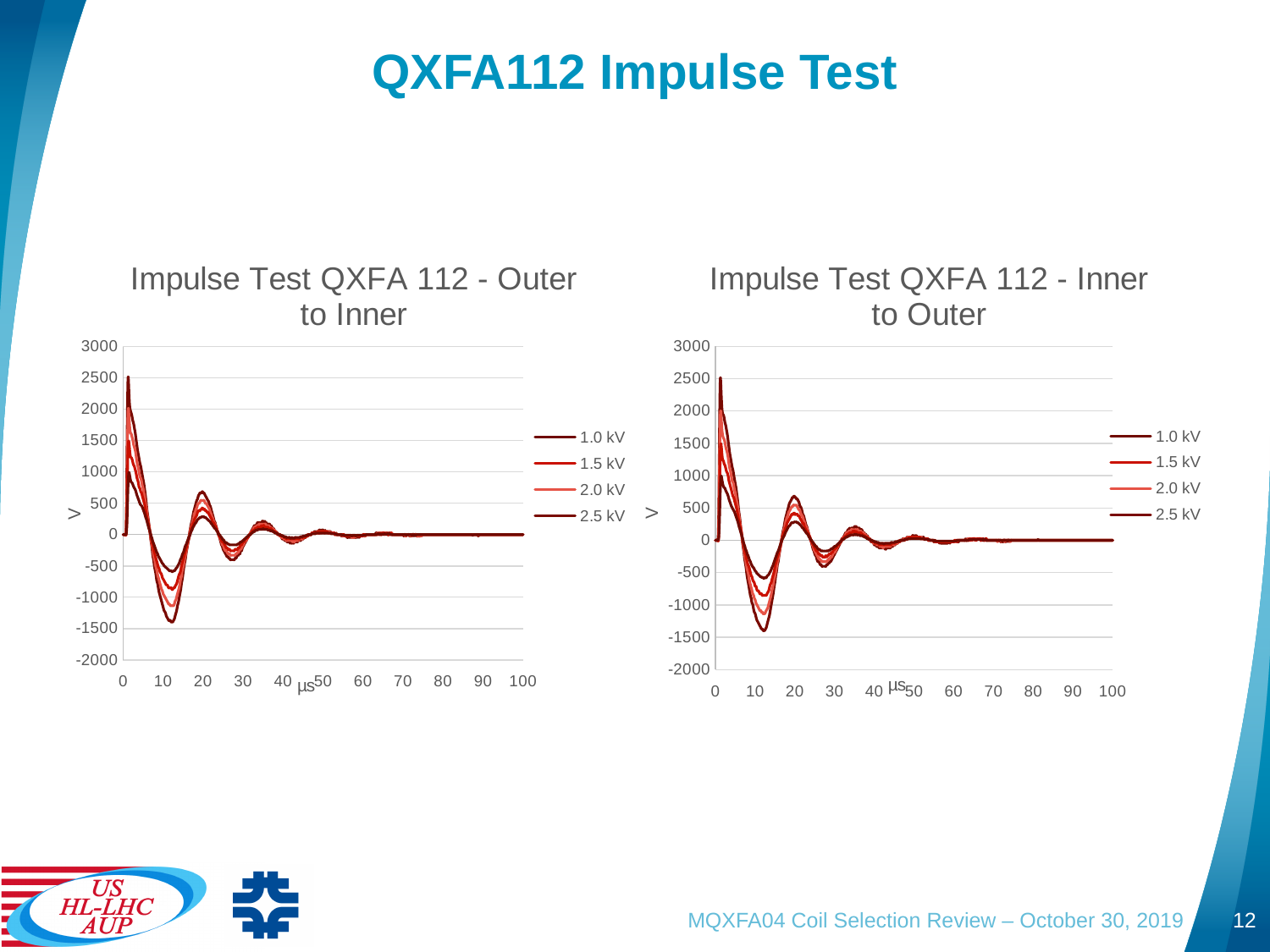
In the "Impulse Test QXFA 112 - Inner to Outer" chart, is the first trough of the 2.5 kV series greater or less than -1000 V? less How many series does the legend of the "Impulse Test QXFA 112 - Inner to Outer" chart list? 4 What is the maximum value shown on the y axis of the "Impulse Test QXFA 112 - Inner to Outer" chart? 3000 In the "Impulse Test QXFA 112 - Outer to Inner" chart, is the initial peak of the 2.5 kV series greater or less than 2000 V? greater What kind of chart is the "Impulse Test QXFA 112 - Outer to Inner" chart? line chart In the "Impulse Test QXFA 112 - Outer to Inner" chart, which series reaches the highest peak voltage? 2.5 kV In the "Impulse Test QXFA 112 - Inner to Outer" chart, which series reaches the lowest (most negative) voltage? 2.5 kV In the "Impulse Test QXFA 112 - Outer to Inner" chart, is the initial peak of the 1.0 kV series greater or less than 1500 V? less What are the legend entries on the "Impulse Test QXFA 112 - Outer to Inner" chart? 1.0 kV, 1.5 kV, 2.0 kV, 2.5 kV In the "Impulse Test QXFA 112 - Outer to Inner" chart, how does the amplitude of the oscillation change as time increases along the x axis? It decays toward 0 In the "Impulse Test QXFA 112 - Inner to Outer" chart, which series has the higher initial peak, 1.0 kV or 2.5 kV? 2.5 kV What is the x-axis unit label on the "Impulse Test QXFA 112 - Inner to Outer" chart? µs